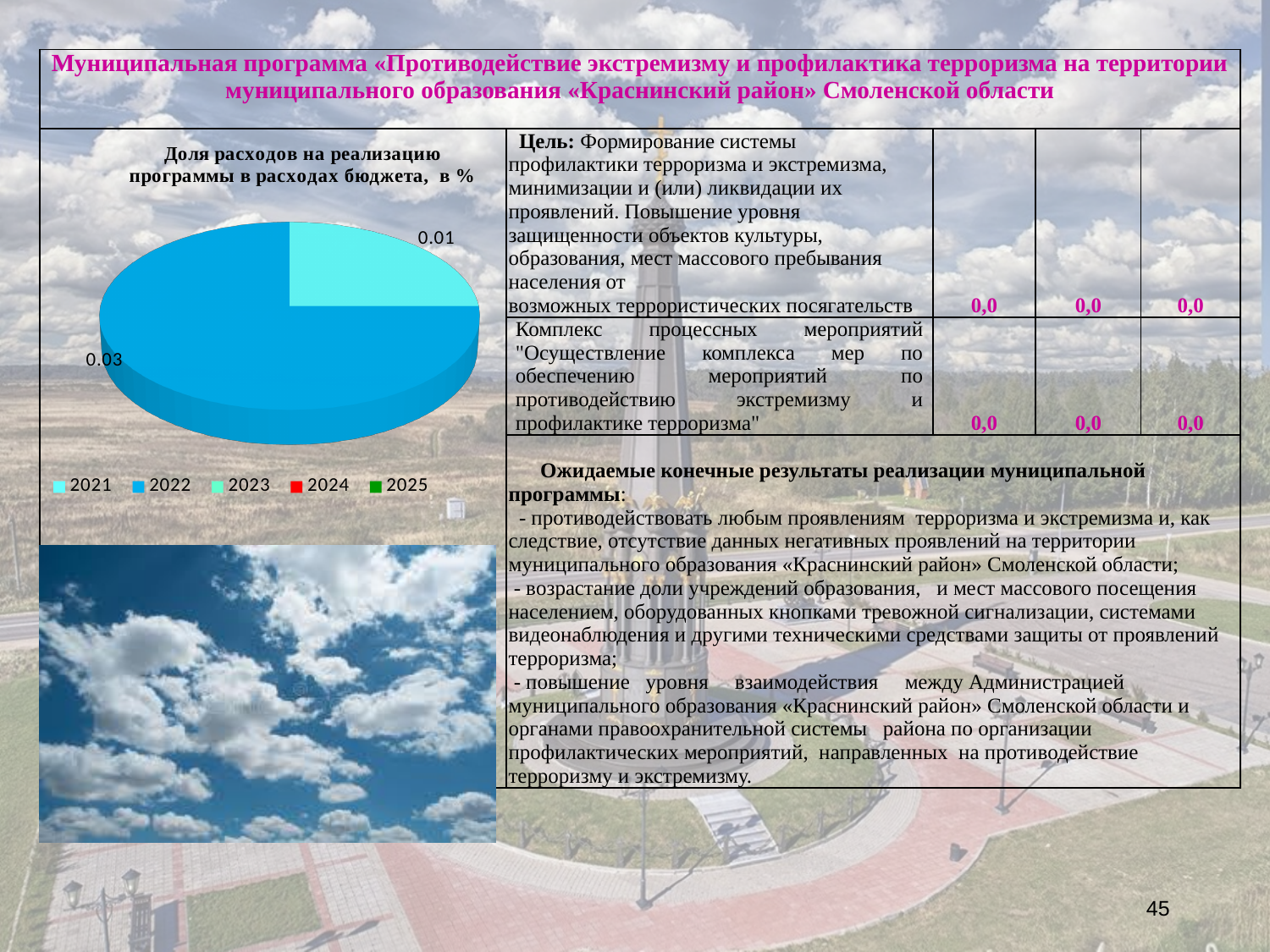
What share of the pie does the 2022 slice represent? 75% What share of the pie does the 2021 slice represent? 25% What is the difference between the values for 2022 and 2021 in the pie chart? 0.02 Which year has the largest slice in the pie chart? 2022 What is the title of the pie chart? Доля расходов на реализацию программы в расходах бюджета, в % How many entries does the legend of the pie chart list? 5 How many slices with data labels are visible in the pie chart? 2 What value is shown for 2021 in the pie chart? 0.01 What kind of chart is shown on the slide? pie chart What colour is the 2022 slice in the pie chart? blue What value is shown for 2022 in the pie chart? 0.03 Which is larger in the pie chart, the value for 2021 or the value for 2022? 2022